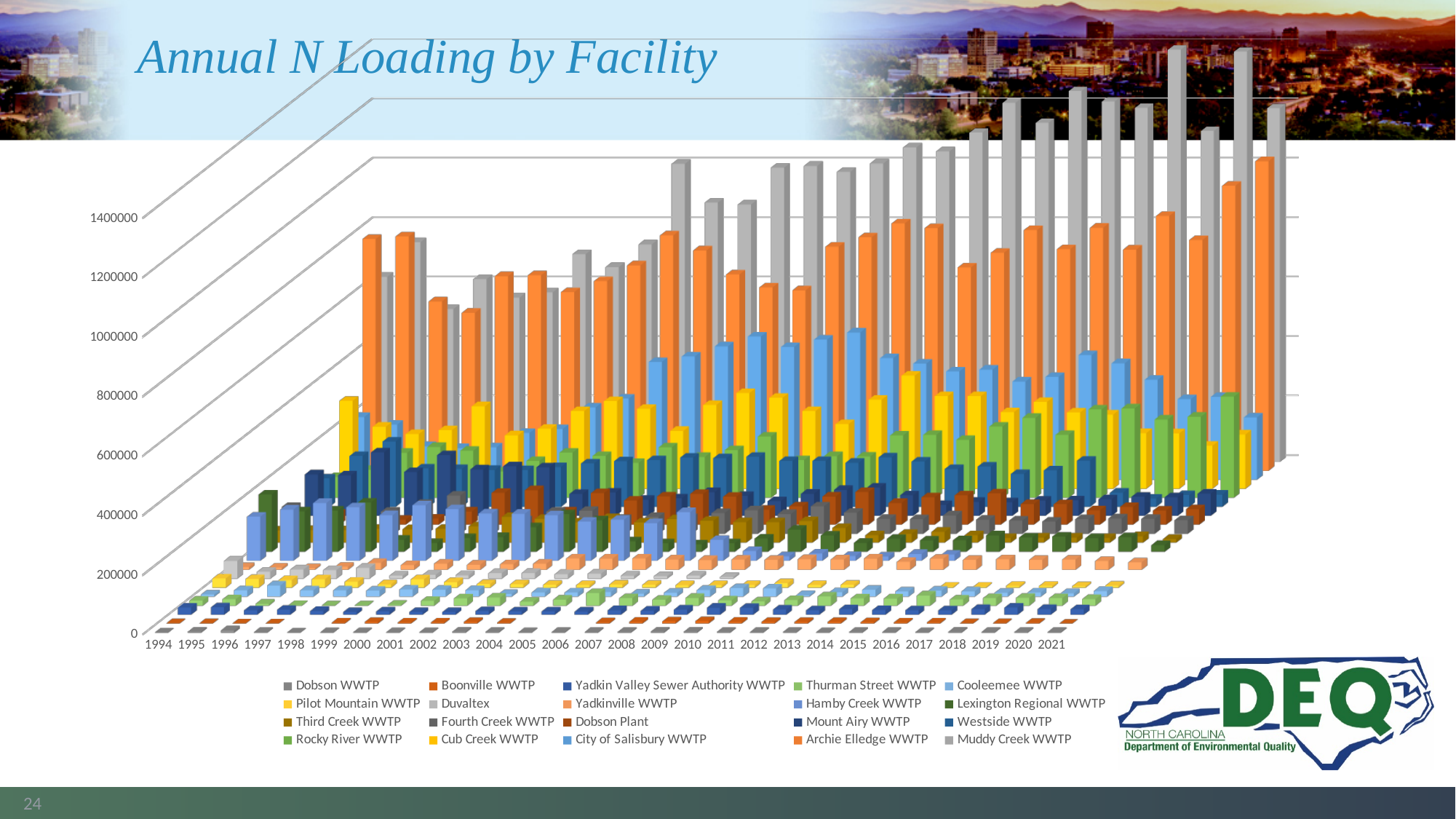
How many series does the legend list? 20 What is the last year shown on the x axis? 2021 What is the highest value labelled on the vertical axis? 1400000 What is the title of the chart? Annual N Loading by Facility What is the first year shown on the x axis? 1994 Which series is listed first in the legend? Dobson WWTP What kind of chart is shown on the slide? bar chart How many years are shown along the x axis? 28